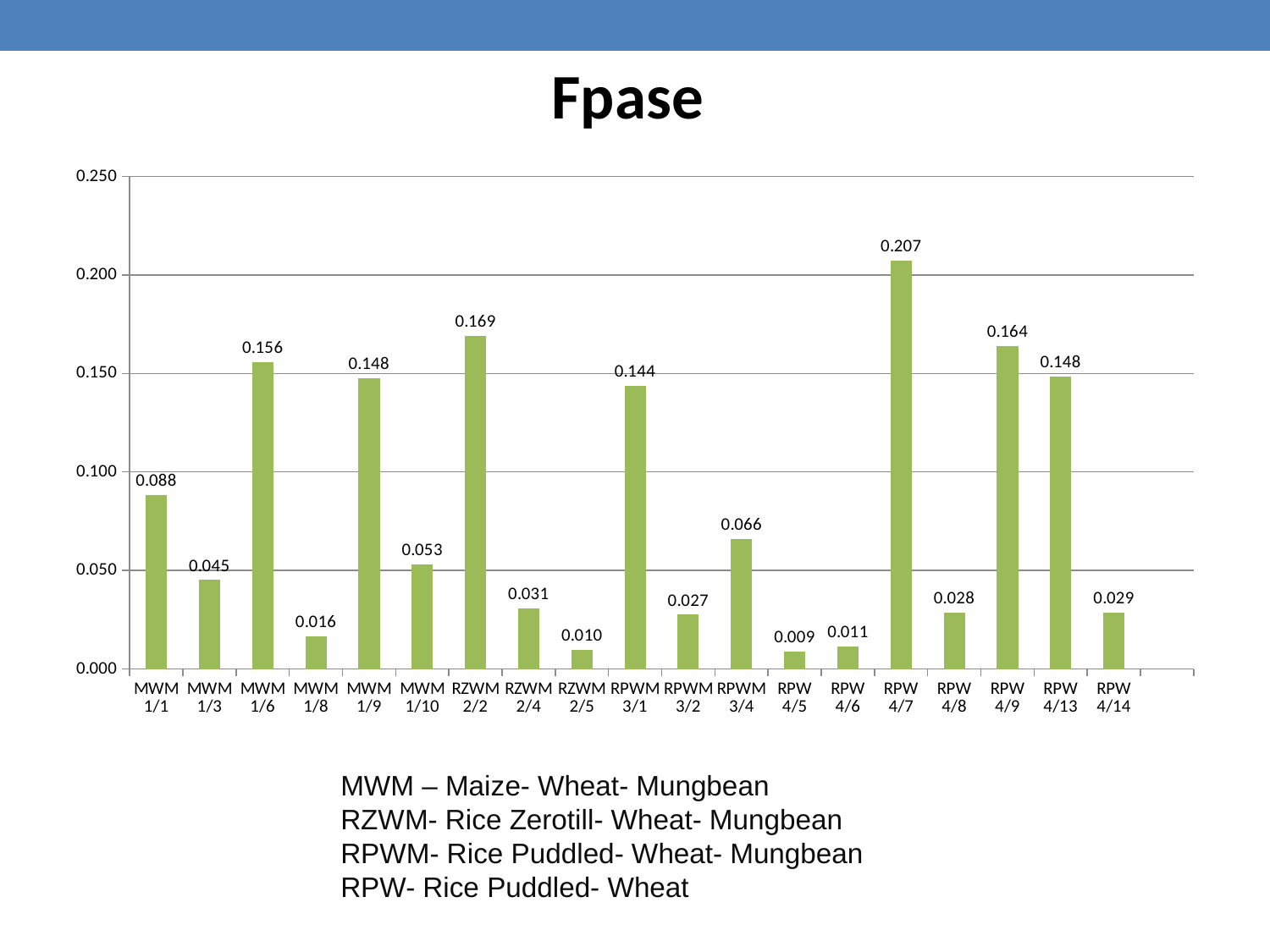
How many categories are shown on the x axis of the chart? 19 Is the Fpase value for RPW 4/7 greater or less than 0.200? greater What is the difference between the Fpase values for RPW 4/7 and RZWM 2/2? 0.038 What is the Fpase value for RZWM 2/2? 0.169 What is the difference between the Fpase values for MWM 1/6 and MWM 1/1? 0.068 Which category has the highest Fpase value? RPW 4/7 What is the Fpase value for MWM 1/1? 0.088 What is the Fpase value for RPW 4/7? 0.207 What kind of chart is shown on the slide? Bar chart What is the Fpase value for RPWM 3/4? 0.066 According to the slide, what does MWM stand for? Maize- Wheat- Mungbean Which has a larger Fpase value, RPW 4/9 or RPWM 3/1? RPW 4/9